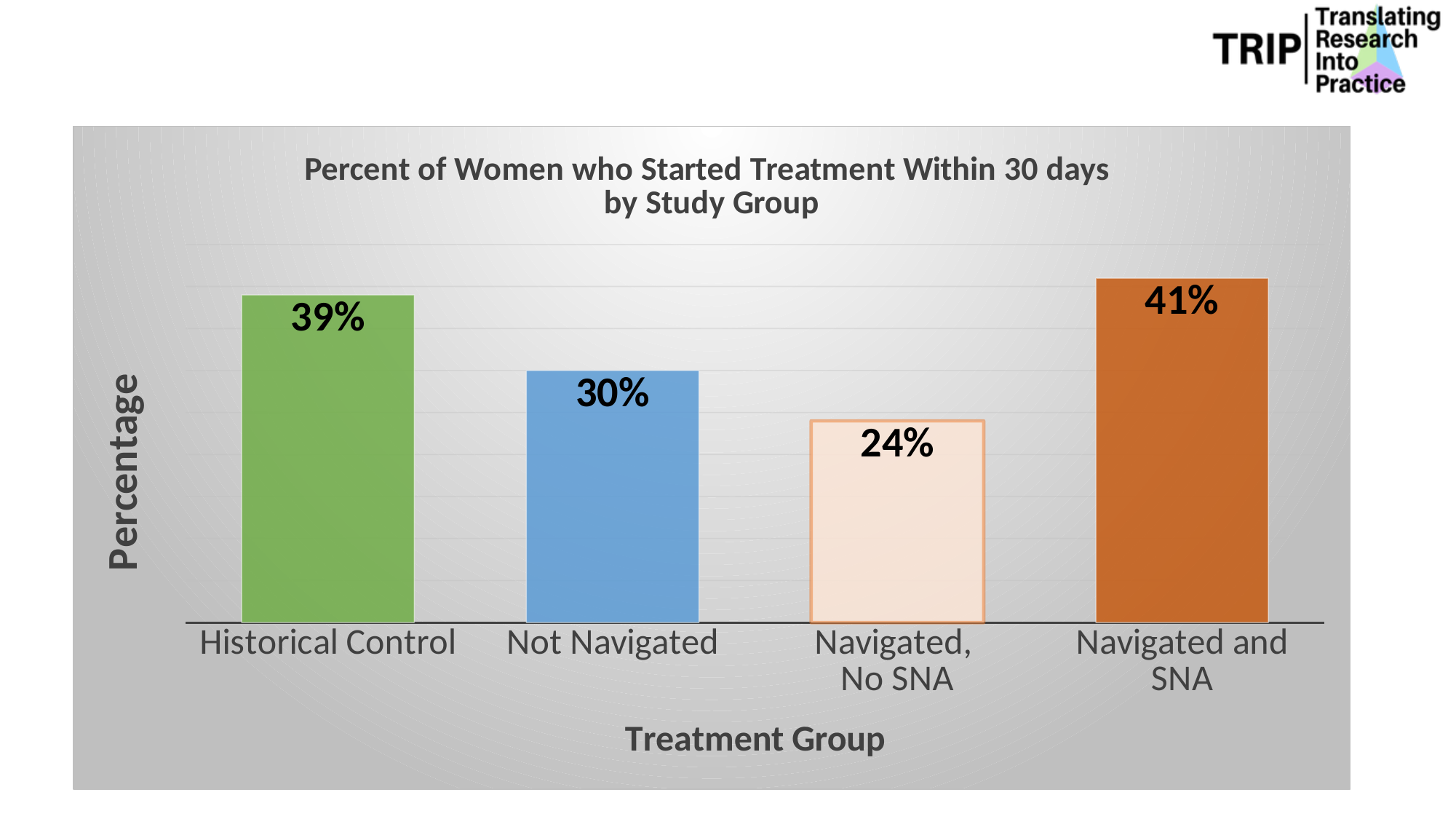
What kind of chart is shown on the slide? Bar chart What is the difference between the values for Navigated and SNA and Navigated, No SNA? 17% Which is larger, the value for Historical Control or the value for Not Navigated? Historical Control How many study groups are shown in the chart? 4 What is the difference between the values for Historical Control and Not Navigated? 9% What is the value for Not Navigated? 30% What is the value for Navigated, No SNA? 24% Which study group has the lowest percentage? Navigated, No SNA Which study group has the highest percentage? Navigated and SNA What is the value for Navigated and SNA? 41% What is the title of the chart? Percent of Women who Started Treatment Within 30 days by Study Group What is the value for Historical Control? 39%